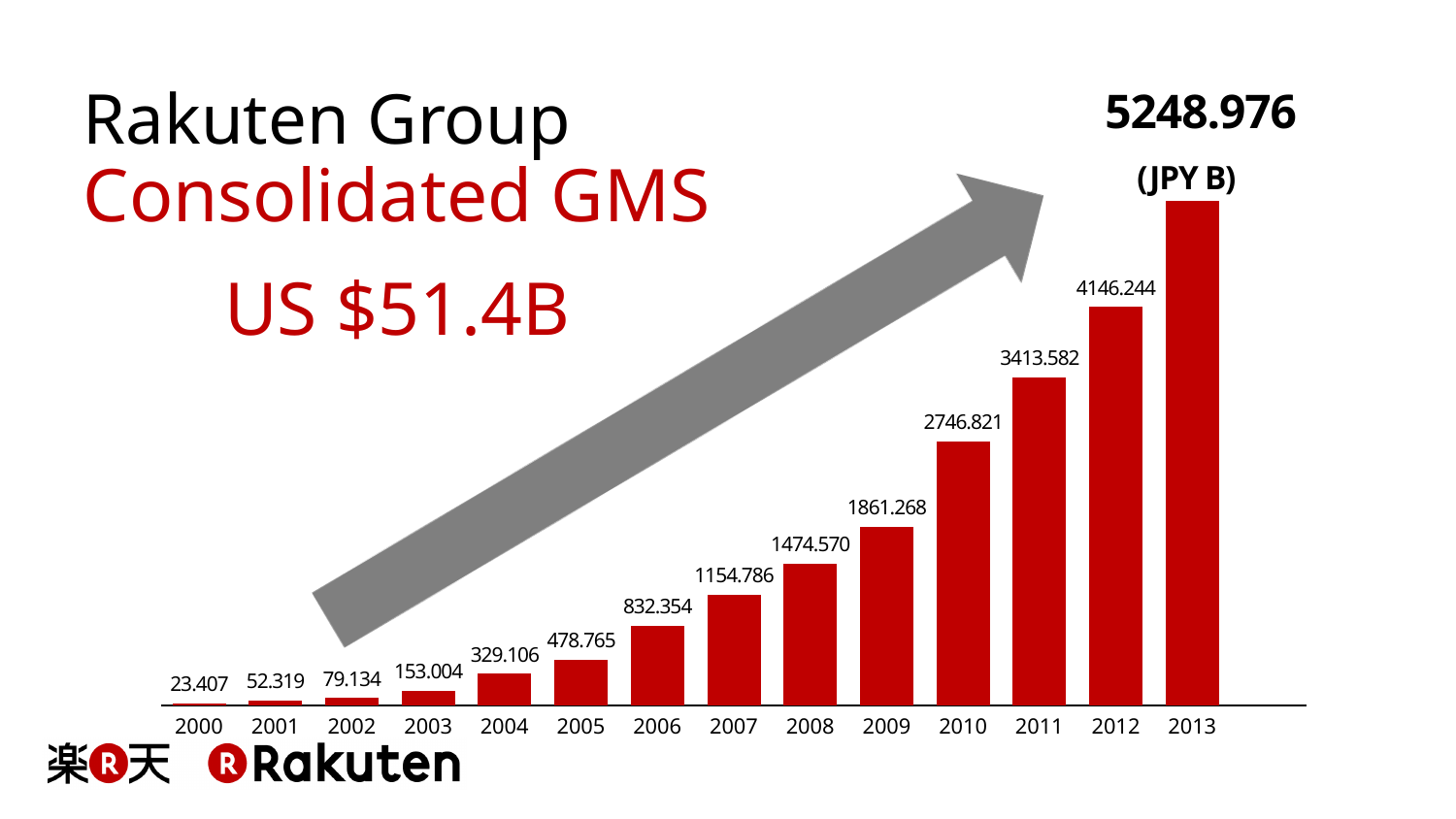
How many years are shown on the chart? 14 What unit is indicated for the chart values? JPY B Which year has the lowest Consolidated GMS? 2000 Which year has a larger Consolidated GMS, 2006 or 2007? 2007 What is the Consolidated GMS value for 2013? 5248.976 What is the Consolidated GMS value for 2003? 153.004 What kind of chart is shown on the slide? Bar chart What is the difference between the 2013 and 2012 Consolidated GMS values? 1102.732 What is the difference between the 2010 and 2009 Consolidated GMS values? 885.553 Which year has the highest Consolidated GMS? 2013 Do the Consolidated GMS values rise or fall from 2000 to 2013? Rise What is the Consolidated GMS value for 2008? 1474.570